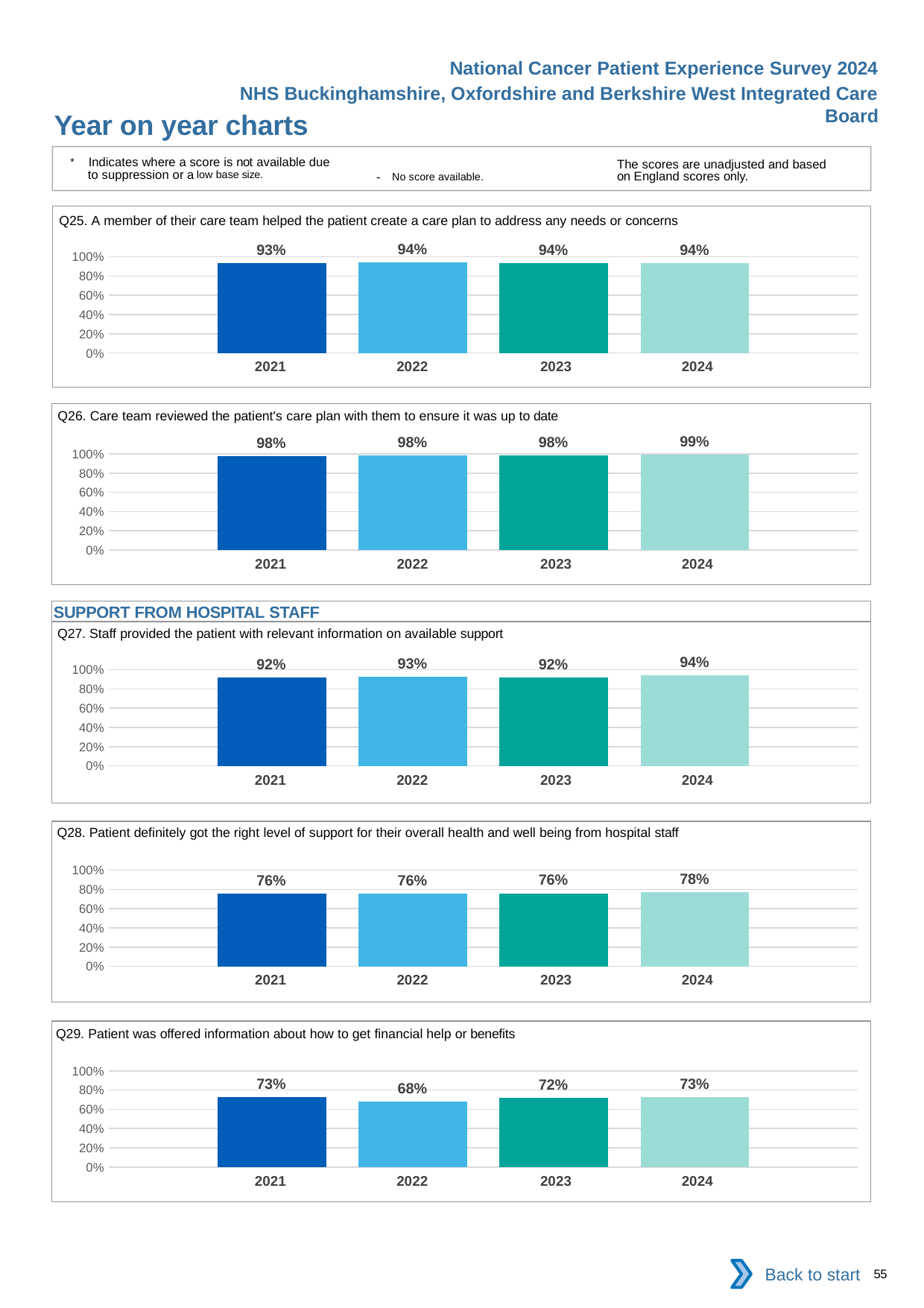
In the Q28 chart, what is the value for 2024? 78% In the Q27 chart, what is the difference between the 2024 value and the 2023 value? 2% In the Q29 chart, which is larger, the value for 2023 or the value for 2022? 2023 In the Q28 chart, is the value for 2022 greater or less than 80%? less In the Q26 chart, which year has the highest value? 2024 In the Q29 chart, what is the difference between the 2021 value and the 2022 value? 5% In the Q25 chart, what is the value for 2021? 93% In the Q29 chart, which year has the lowest value? 2022 What kind of chart is the Q27 chart? Bar chart How many years are shown on the x axis of the Q28 chart? 4 In the Q27 chart, what is the value for 2022? 93% What is the section heading printed above the Q27 chart? SUPPORT FROM HOSPITAL STAFF